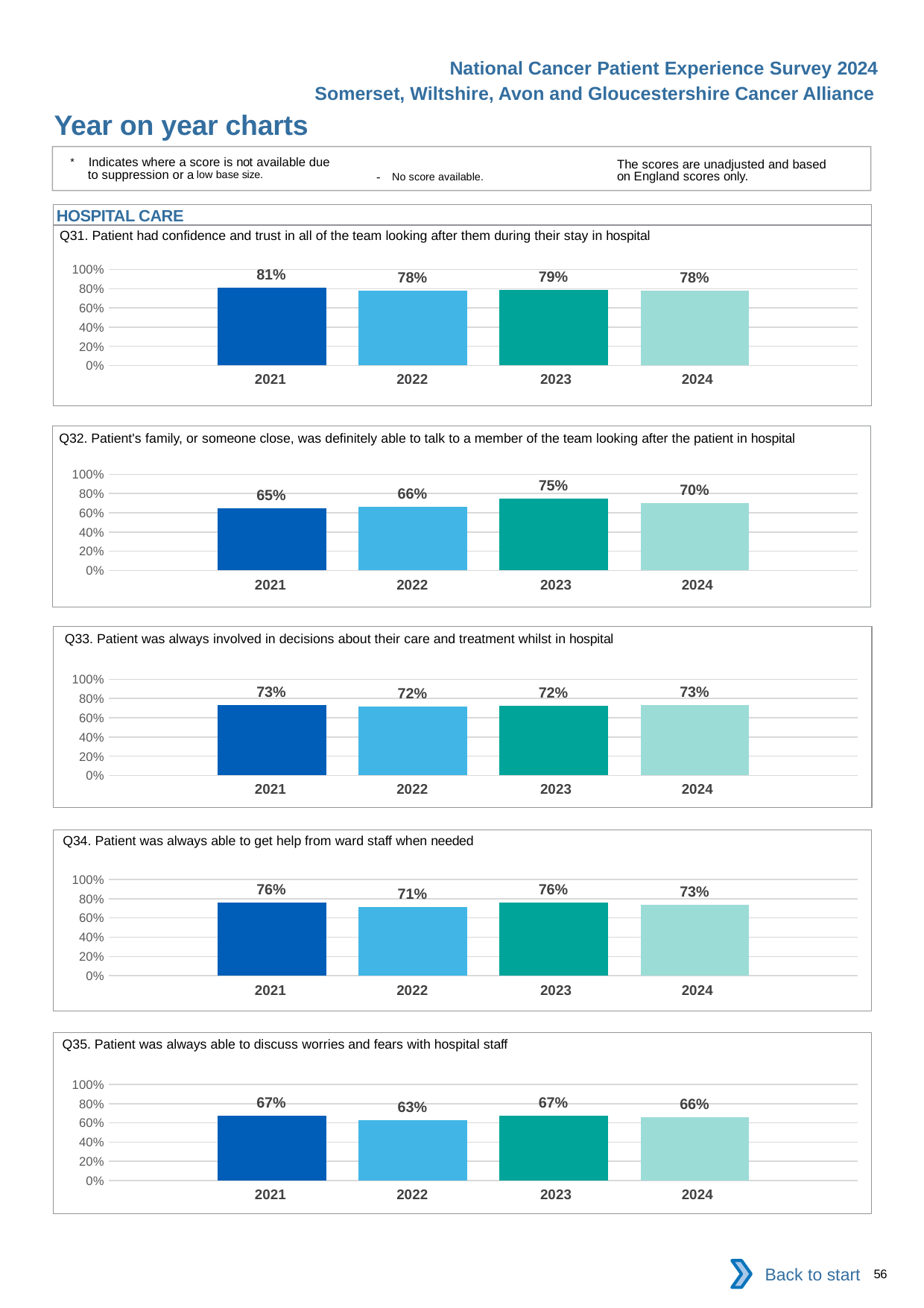
How many charts are shown under the HOSPITAL CARE heading on this slide? 5 In the Q31 chart (confidence and trust in the team), what is the value for 2021? 81% In the Q34 chart (able to get help from ward staff), which year has the lowest value? 2022 In the Q33 chart (involved in decisions about care), what is the value for 2024? 73% How many years are plotted in the Q31 chart (confidence and trust in the team)? 4 In the Q32 chart (family able to talk to a member of the team), which year has the highest value? 2023 In the Q35 chart (discuss worries and fears with hospital staff), what is the difference between the 2021 and 2022 values? 4 percentage points In the Q35 chart (discuss worries and fears with hospital staff), what is the value for 2022? 63% In the Q32 chart (family able to talk to a member of the team), what is the difference between the 2023 and 2021 values? 10 percentage points In the Q31 chart (confidence and trust in the team), is the value for 2022 greater or less than 60%? greater What kind of chart is used for Q33 (involved in decisions about care)? Bar chart In the Q34 chart (able to get help from ward staff), is the value for 2023 or 2024 larger? 2023